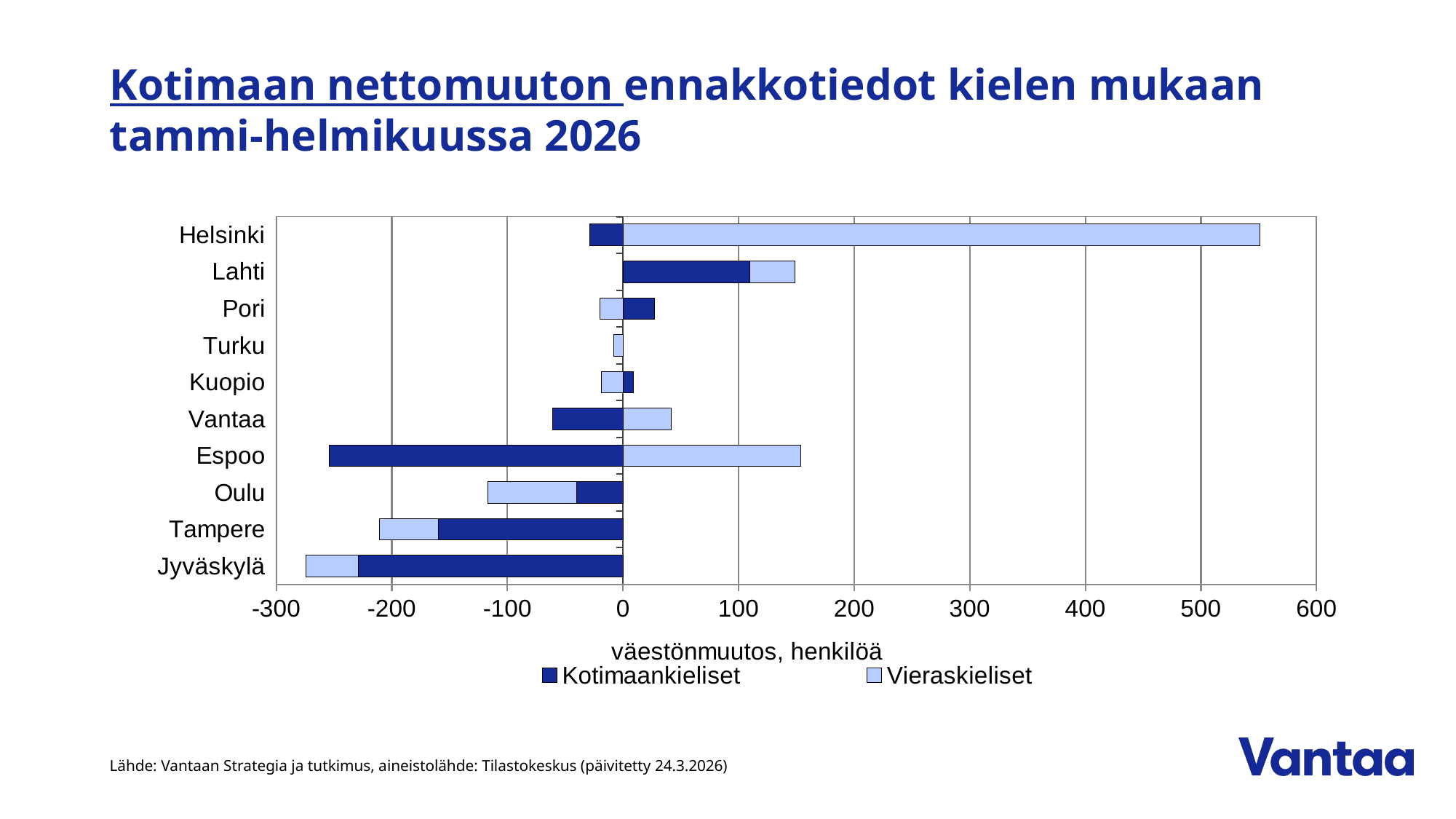
Which is larger, the Kotimaankieliset value for Lahti or for Pori? Lahti Which city has the lowest Kotimaankieliset value? Espoo How many cities are shown on the chart? 10 Which city has the highest Vieraskieliset value? Helsinki What is the title of the x axis? väestönmuutos, henkilöä Is the Kotimaankieliset value for Espoo greater or less than -200? less How many series does the legend list? 2 Which city has the highest Kotimaankieliset value? Lahti Is the Vieraskieliset value for Helsinki greater or less than 500? greater Which is larger, the Vieraskieliset value for Espoo or for Vantaa? Espoo What kind of chart is shown on the slide? bar chart Is the Kotimaankieliset value for Tampere greater or less than -100? less